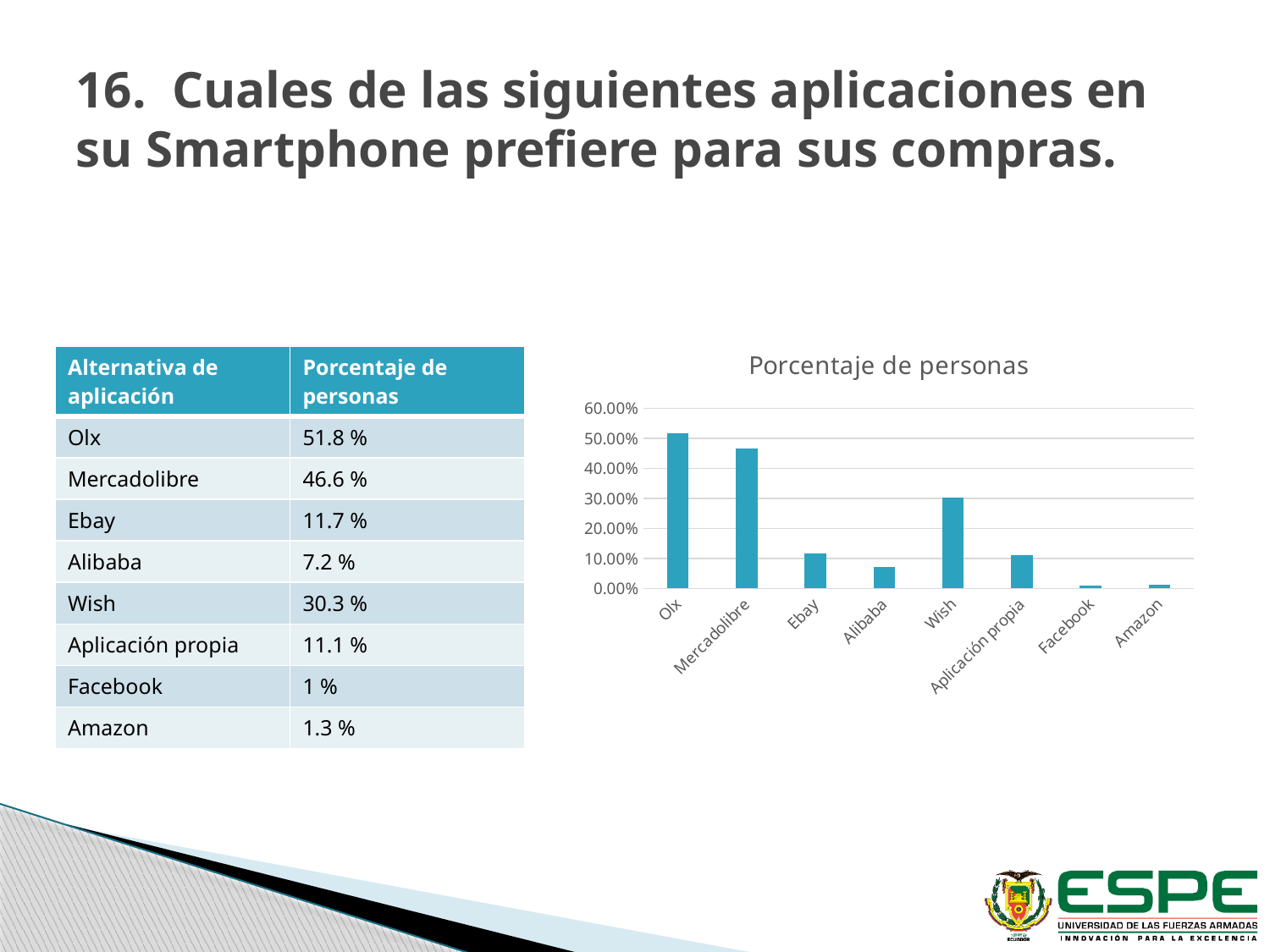
What is the title of the chart? Porcentaje de personas What is the value for Alibaba? 7.2 % What is the difference between the values for Olx and Mercadolibre? 5.2 % Which category has the lowest value in the chart? Facebook What is the value for Wish? 30.3 % Is the value for Aplicación propia greater or less than 20.00%? less How many categories are plotted on the x axis of the chart? 8 Is the value for Olx greater or less than 50.00%? greater What kind of chart is shown on the slide? bar chart Which is larger, the value for Ebay or the value for Wish? Wish Which category has the highest value in the chart? Olx What is the value for Mercadolibre? 46.6 %